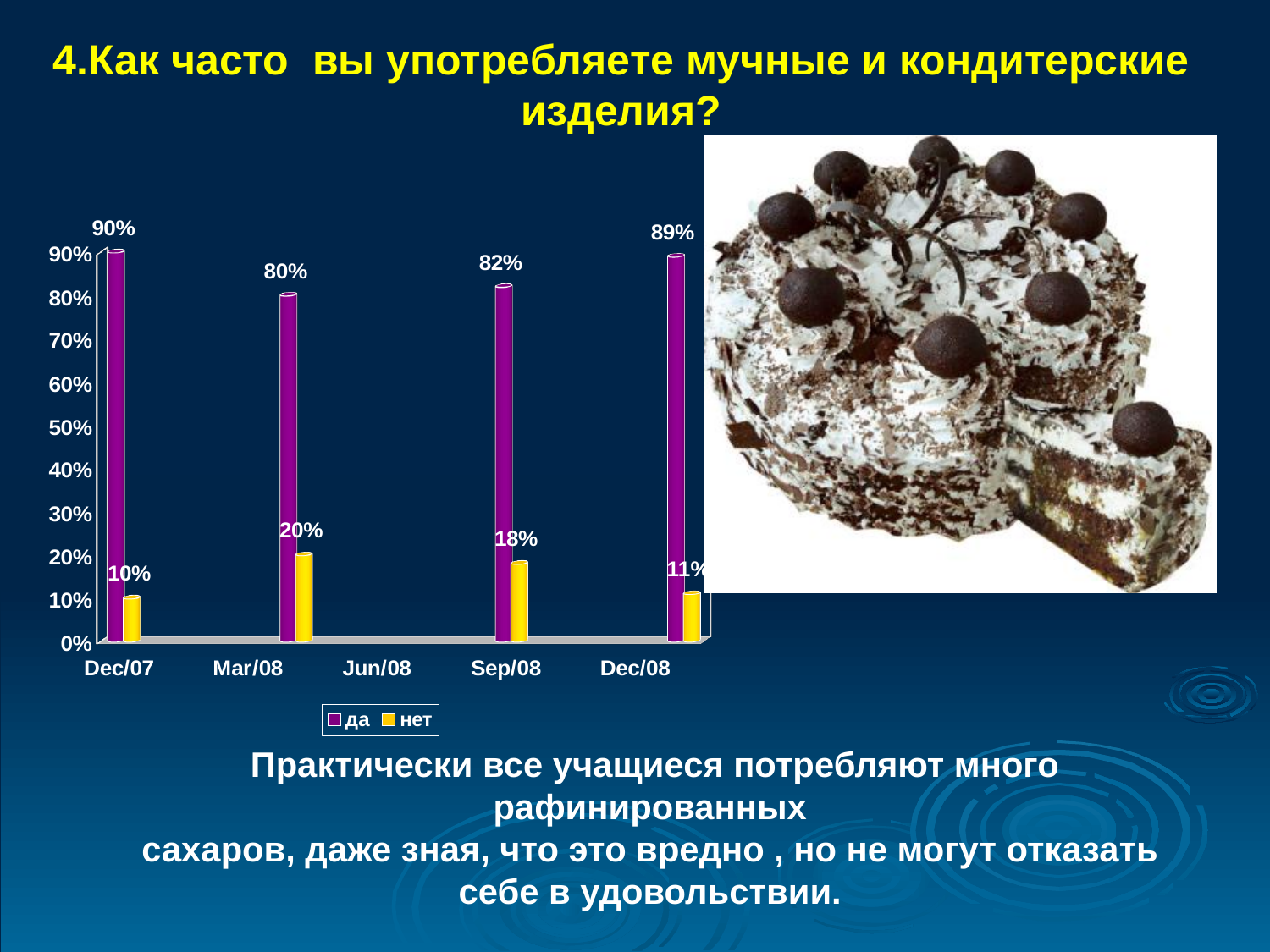
What is the value of the "нет" series for Dec/07? 10% What is the difference between the "да" and "нет" values for Mar/08? 60% What is the value of the "да" series for Mar/08? 80% What colour are the bars for the "нет" series? Yellow What kind of chart is shown on the slide? Bar chart What is the value of the "нет" series for Mar/08? 20% What is the value of the "да" series for Dec/07? 90% Which category has the lowest value for the "да" series? Mar/08 Which category has the highest value for the "да" series? Dec/07 Which is larger for Dec/07: the "да" value or the "нет" value? да What are the two legend entries of the chart? да, нет How many series does the legend list? 2